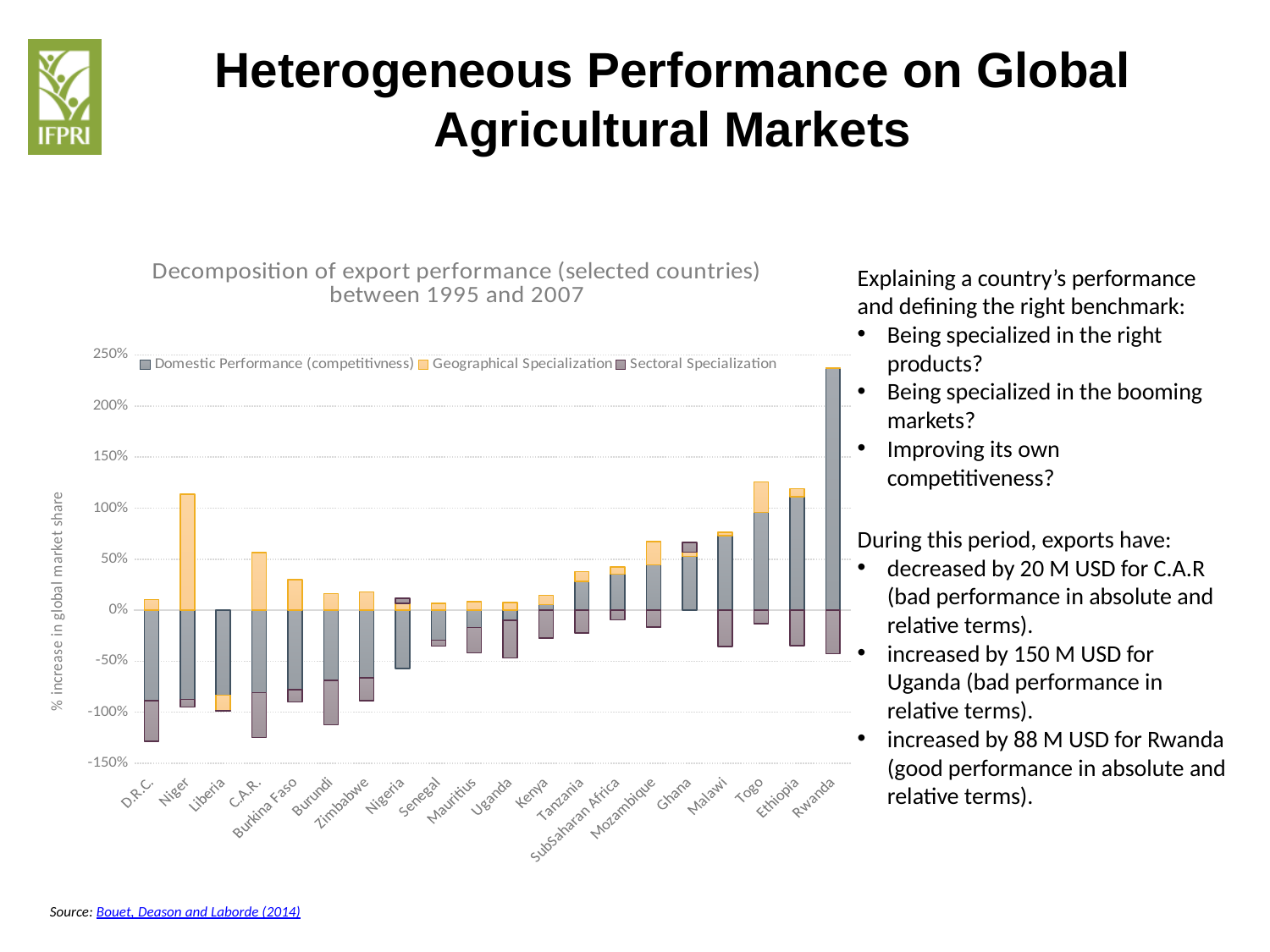
Is the Domestic Performance (competitivness) value for D.R.C. greater or less than -50%? less How many countries/regions are shown on the x axis of the chart? 20 Do the Domestic Performance (competitivness) values generally rise or fall moving from left to right along the x axis? rise How many series does the chart legend list? 3 Is the Geographical Specialization value for Niger greater or less than 100%? greater What kind of chart is shown on the slide? Stacked bar chart What is the title of the chart? Decomposition of export performance (selected countries) between 1995 and 2007 What is the label of the vertical axis of the chart? % increase in global market share Is the Domestic Performance (competitivness) value for Ethiopia greater or less than 100%? greater Which has the larger Domestic Performance (competitivness) value, Togo or Rwanda? Rwanda Which country has the highest Domestic Performance (competitivness) value in the chart? Rwanda